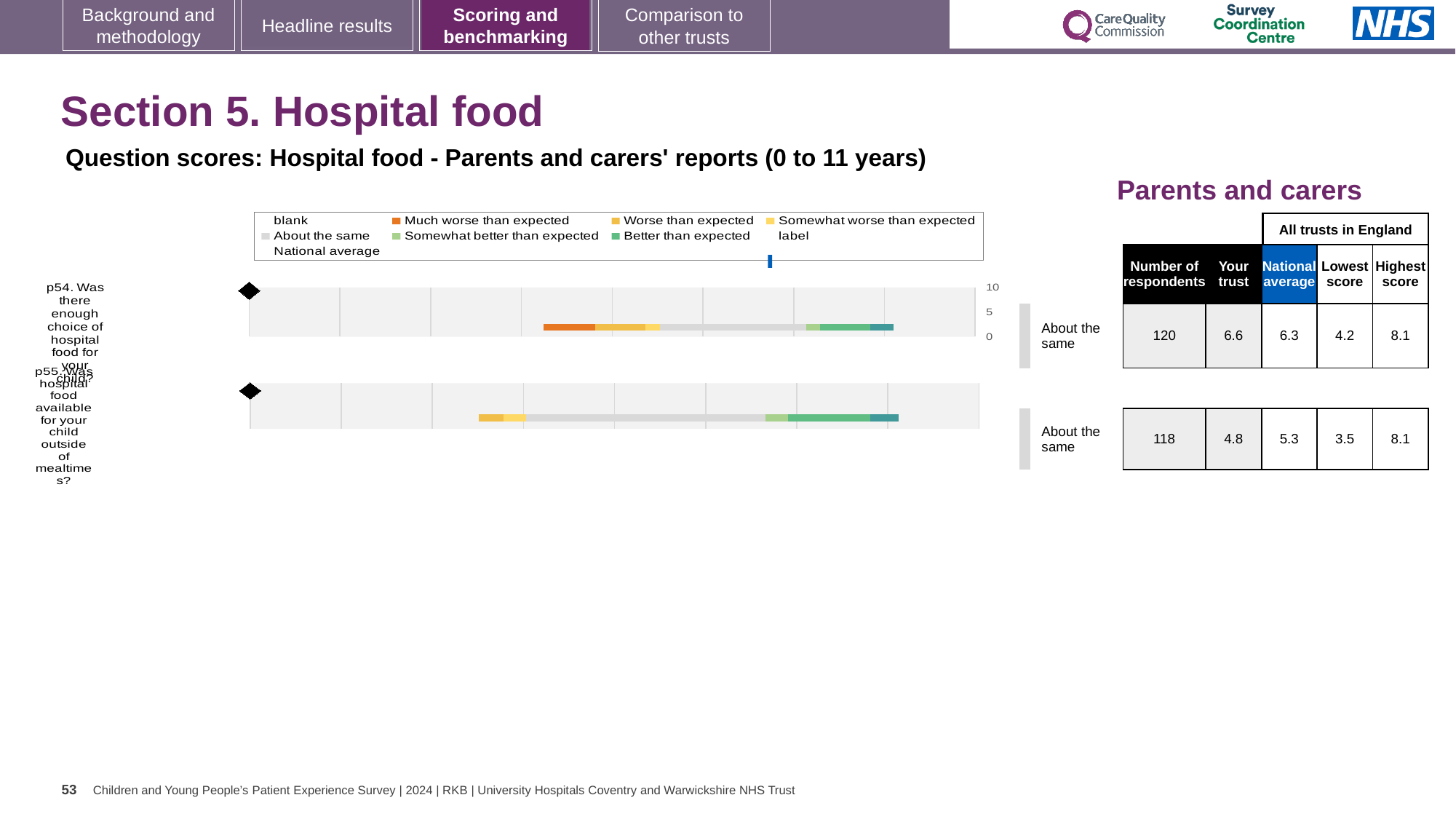
What is the national average score for p54? 6.3 What benchmarking category is shown for p54? About the same In the chart legend, what colour represents 'Much worse than expected'? orange What is the 'Your trust' score for p55 (hospital food available outside of mealtimes)? 4.8 What kind of chart is used to show the question scores for hospital food? bar chart How many survey questions are plotted in the hospital food chart? 2 What is the highest score among all trusts in England for p55? 8.1 By how much does the trust's score for p54 exceed the national average for p54? 0.3 Which question has the higher 'Your trust' score, p54 or p55? p54 What is the 'Your trust' score for p54 (enough choice of hospital food for your child)? 6.6 How many respondents answered p55? 118